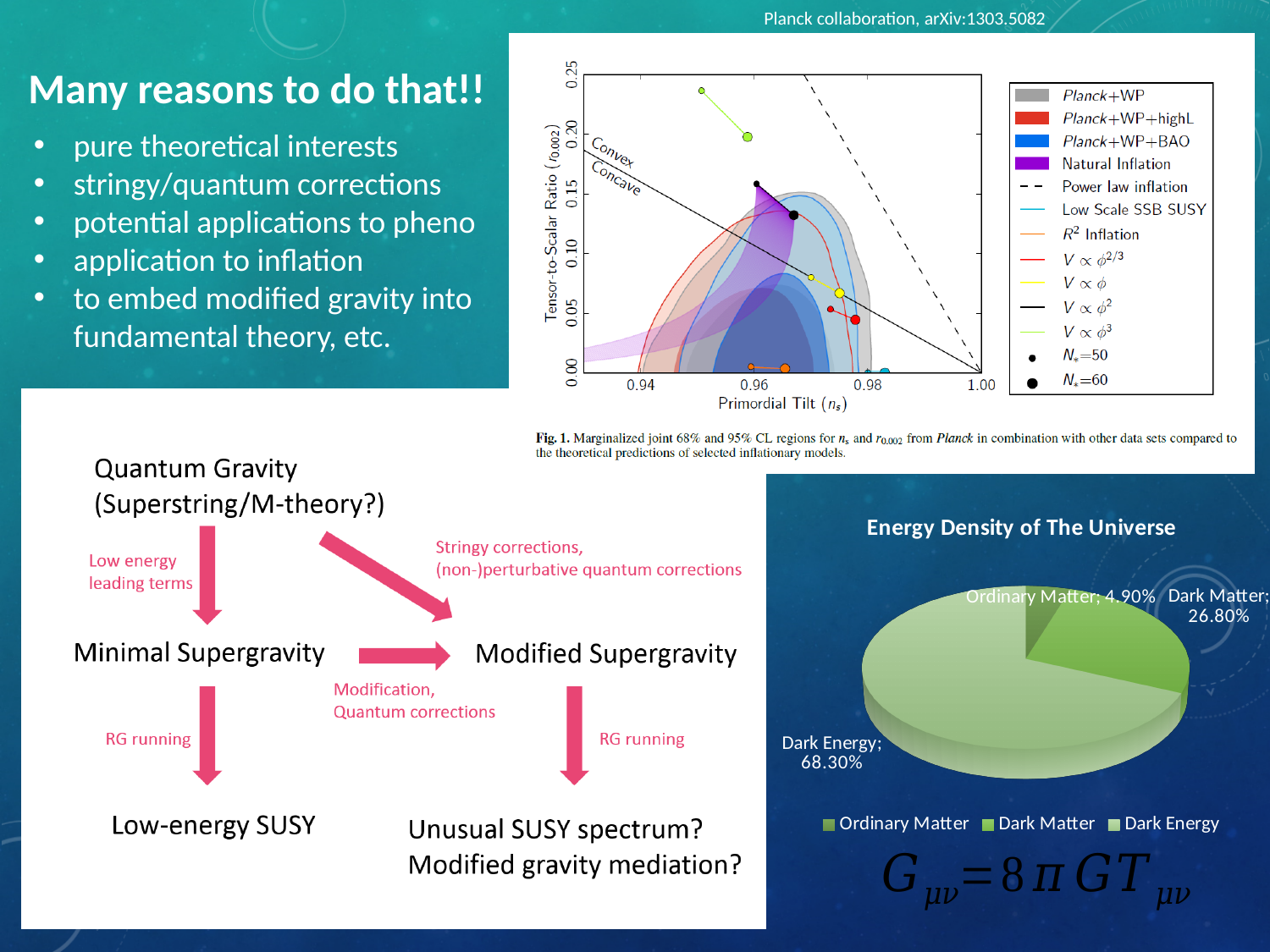
In the pie chart titled "Energy Density of The Universe", what percentage is shown for Ordinary Matter? 4.90% How many entries does the legend of the pie chart titled "Energy Density of The Universe" list? 3 What kind of chart is the "Energy Density of The Universe" chart in the lower right of the slide? Pie chart In the pie chart titled "Energy Density of The Universe", which component has the smallest share? Ordinary Matter In the pie chart titled "Energy Density of The Universe", which is larger: Dark Matter or Ordinary Matter? Dark Matter In the pie chart titled "Energy Density of The Universe", how many percentage points larger is Dark Matter than Ordinary Matter? 21.90% How many slices does the pie chart titled "Energy Density of The Universe" have? 3 In the pie chart titled "Energy Density of The Universe", what percentage is shown for Dark Energy? 68.30% In the pie chart titled "Energy Density of The Universe", what percentage is shown for Dark Matter? 26.80% In the pie chart titled "Energy Density of The Universe", how many percentage points larger is Dark Energy than Dark Matter? 41.50% In the Planck figure at the top right of the slide, what is the label of the x axis? Primordial Tilt (n_s) In the pie chart titled "Energy Density of The Universe", which component has the largest share? Dark Energy